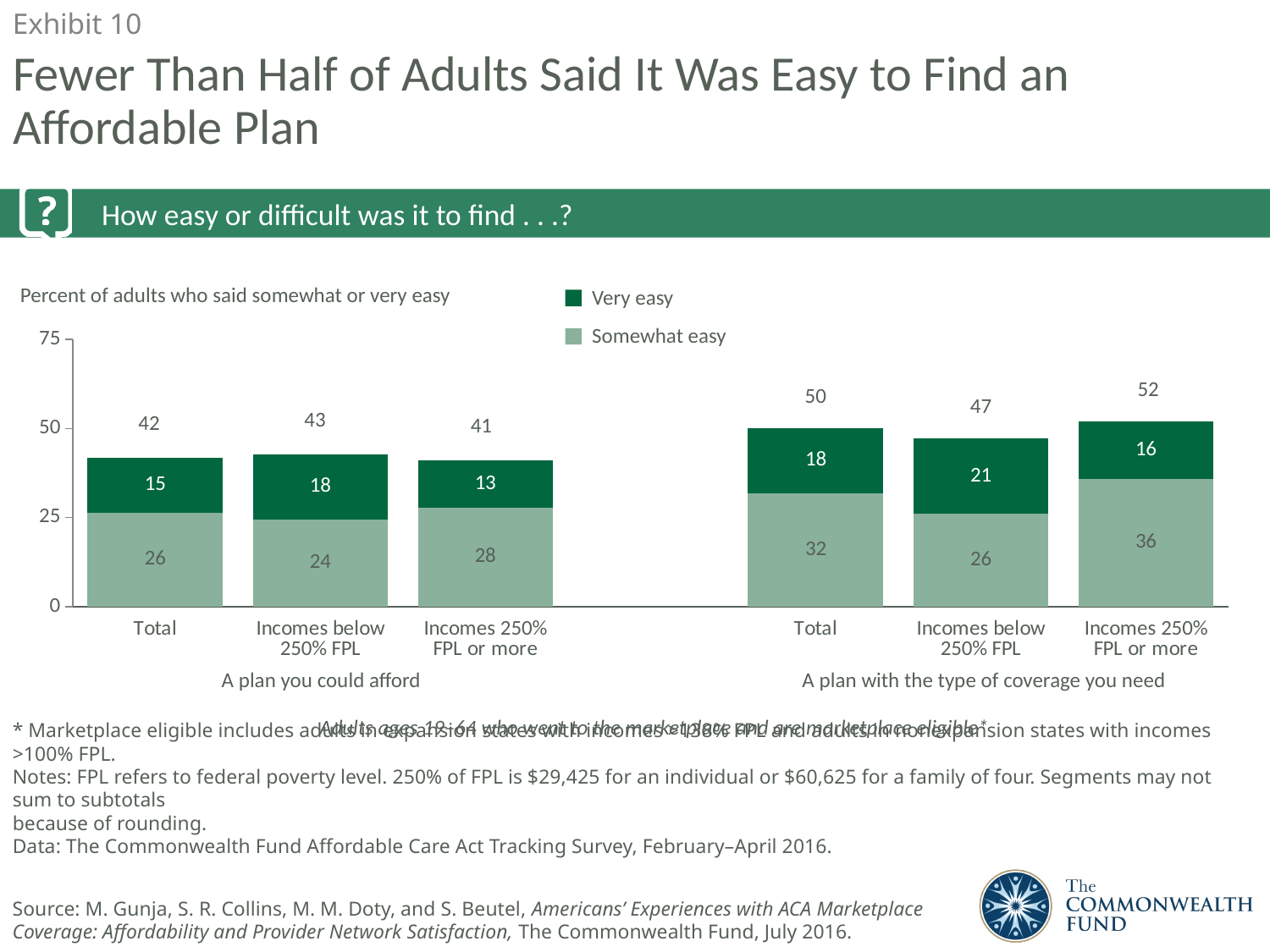
What are the two series named in the legend? Very easy; Somewhat easy Which bar has the lowest total percentage of adults who said somewhat or very easy? Incomes 250% FPL or more (A plan you could afford) What is the 'Somewhat easy' value for Incomes 250% FPL or more under 'A plan with the type of coverage you need'? 36 How many series does the legend list? 2 What is the 'Very easy' value for Incomes below 250% FPL under 'A plan with the type of coverage you need'? 21 What is the total labeled above the bar for Incomes 250% FPL or more under 'A plan with the type of coverage you need'? 52 Which is larger: the 'Somewhat easy' value for Total under 'A plan you could afford' or the 'Somewhat easy' value for Total under 'A plan with the type of coverage you need'? A plan with the type of coverage you need (32) What is the 'Very easy' value for Total under 'A plan you could afford'? 15 What is the difference between the total for Total under 'A plan with the type of coverage you need' (50) and the total for Total under 'A plan you could afford' (42)? 8 Which bar has the highest total percentage of adults who said somewhat or very easy? Incomes 250% FPL or more (A plan with the type of coverage you need) What kind of chart is shown on the slide? Stacked bar chart What is the total labeled above the bar for Incomes 250% FPL or more under 'A plan you could afford'? 41